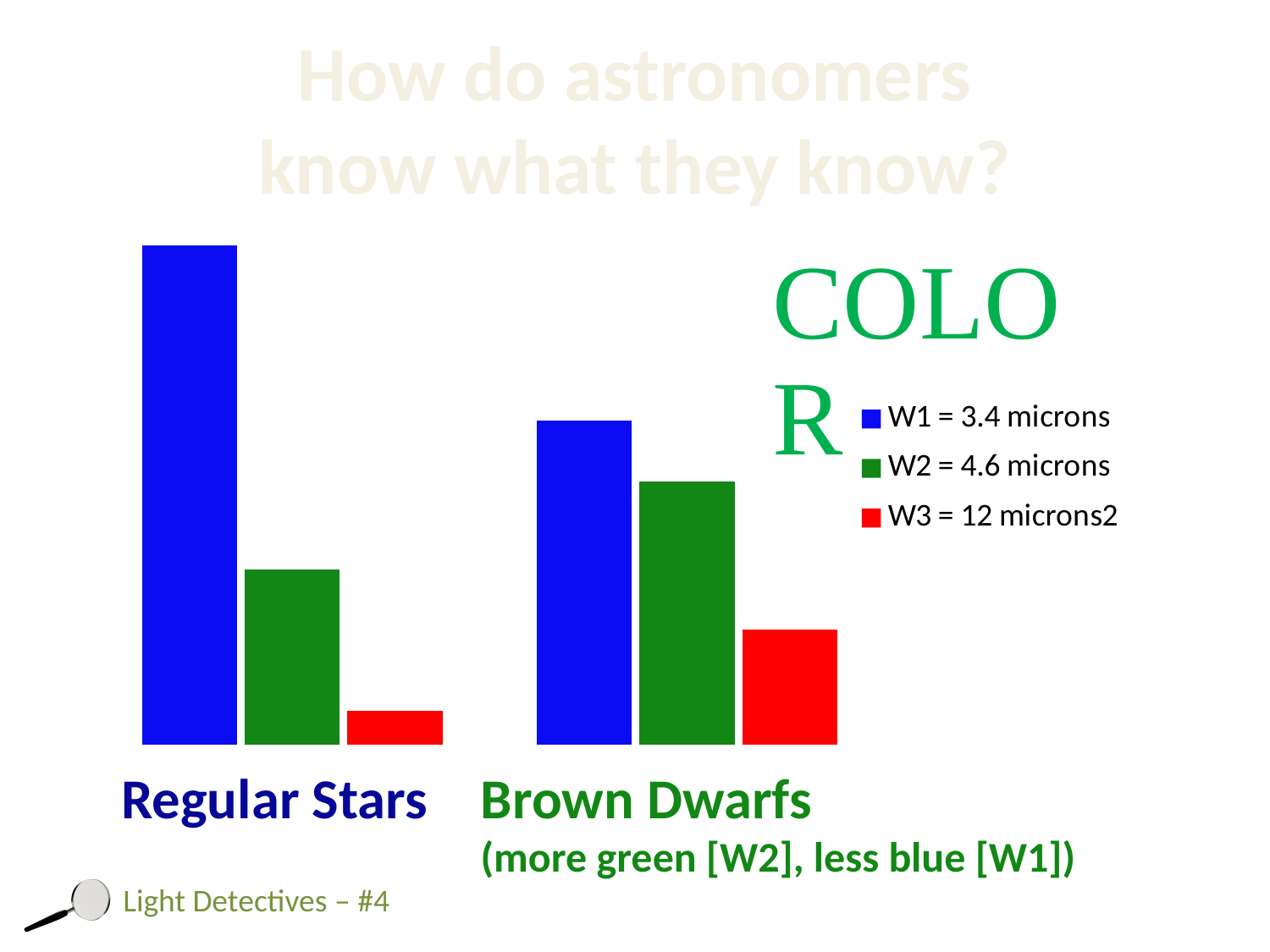
What kind of chart is shown on the slide? bar chart Which series has the tallest bar for Brown Dwarfs? W1 = 3.4 microns Is the W2 bar taller for Regular Stars or for Brown Dwarfs? Brown Dwarfs Which series has the tallest bar for Regular Stars? W1 = 3.4 microns What is the legend label of the red series? W3 = 12 microns2 Which series has the shortest bar for Regular Stars? W3 = 12 microns2 Is the W1 bar taller for Regular Stars or for Brown Dwarfs? Regular Stars How many categories are shown along the bottom of the chart? 2 Is the W3 bar taller for Regular Stars or for Brown Dwarfs? Brown Dwarfs How many series does the legend list? 3 Which series has the shortest bar for Brown Dwarfs? W3 = 12 microns2 What colour represents the W2 = 4.6 microns series? green